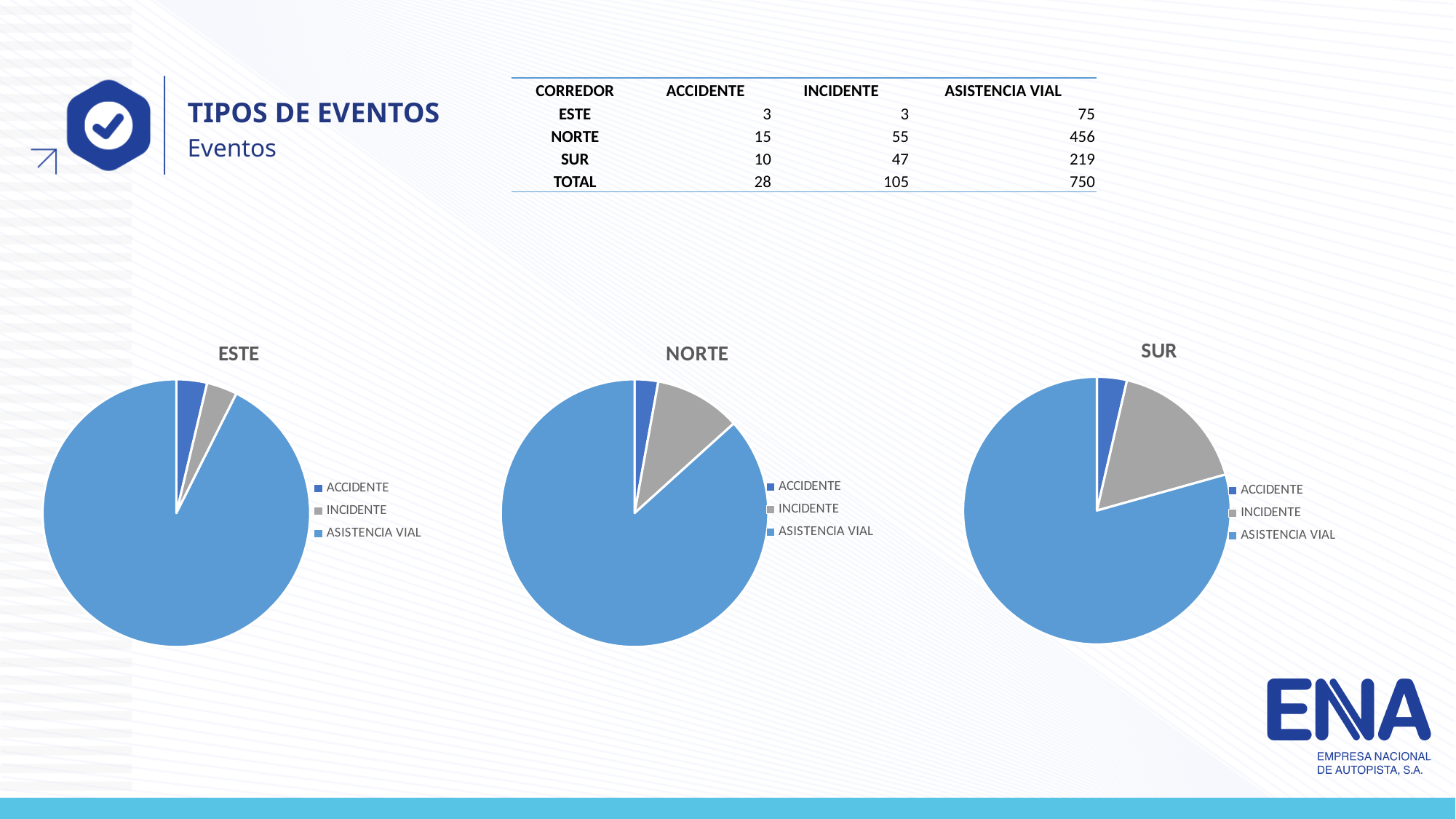
According to the table, what is the ASISTENCIA VIAL value for NORTE? 456 How many pie charts are shown on the slide? 3 In the NORTE pie chart, which category has the smallest slice? ACCIDENTE In the ESTE pie chart, which category has the largest slice? ASISTENCIA VIAL How many categories does the legend of the ESTE pie chart list? 3 In the SUR pie chart, is the INCIDENTE slice larger or smaller than the ACCIDENTE slice? Larger According to the table, what is the INCIDENTE value for SUR? 47 According to the table, what is the difference between the INCIDENTE values for NORTE and SUR? 8 What colour represents ASISTENCIA VIAL in the pie charts? Light blue According to the table, what is the ACCIDENTE value for ESTE? 3 According to the table, what is the TOTAL for ASISTENCIA VIAL across all corridors? 750 What type of chart is used for ESTE, NORTE and SUR? Pie chart